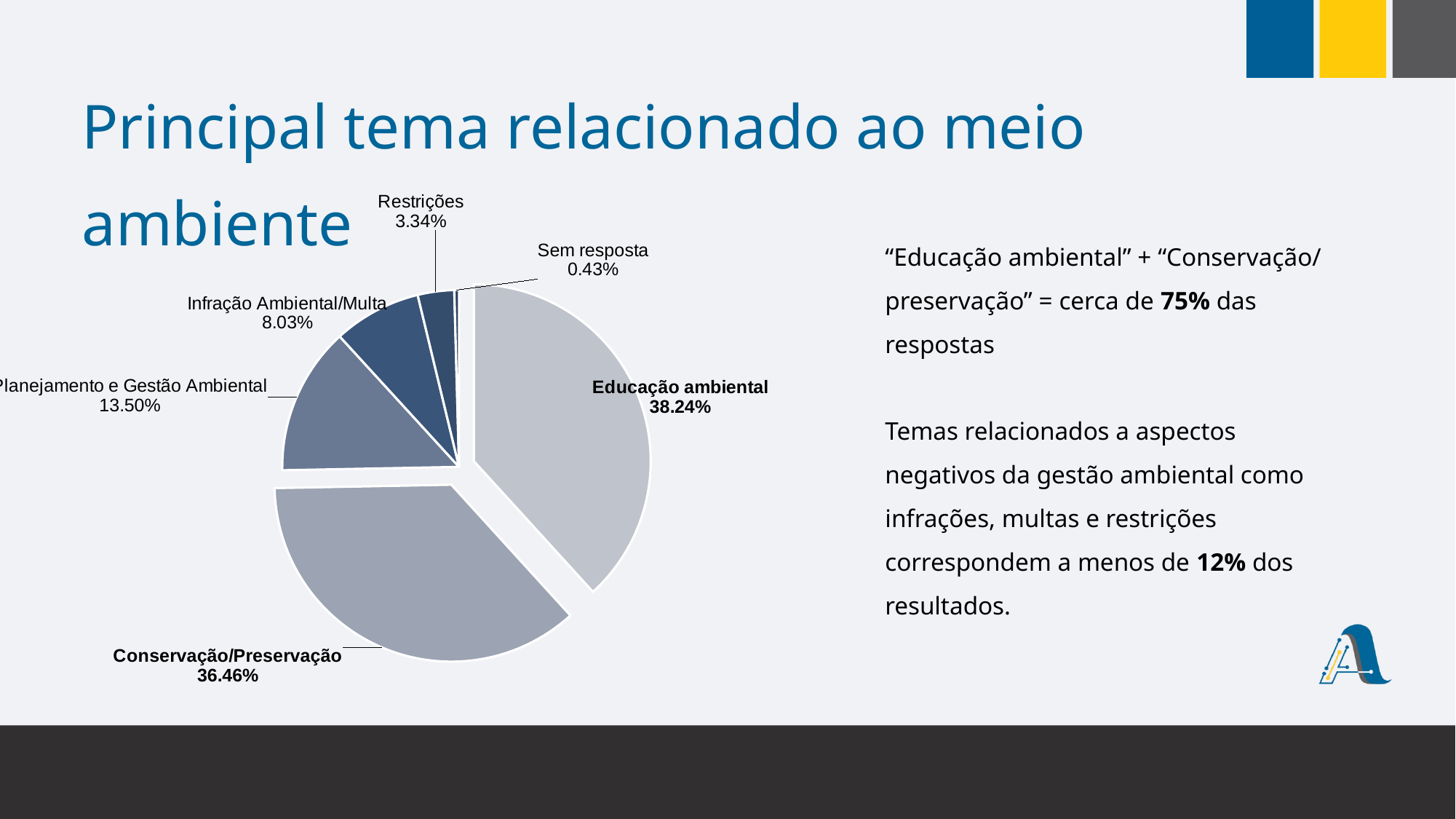
What kind of chart is shown on the slide? Pie chart What percentage is shown for Planejamento e Gestão Ambiental? 13.50% How many slices does the pie chart have? 6 What is the difference in percentage points between Planejamento e Gestão Ambiental and Infração Ambiental/Multa? 5.47 What percentage of responses is labelled for Educação ambiental? 38.24% Which is larger, the share for Restrições or the share for Infração Ambiental/Multa? Infração Ambiental/Multa Which slice of the pie chart is the largest? Educação ambiental What percentage is shown for Restrições? 3.34% Which slice of the pie chart is the smallest? Sem resposta What percentage is shown for Conservação/Preservação? 36.46% What percentage is shown for Sem resposta? 0.43% What percentage is shown for Infração Ambiental/Multa? 8.03%